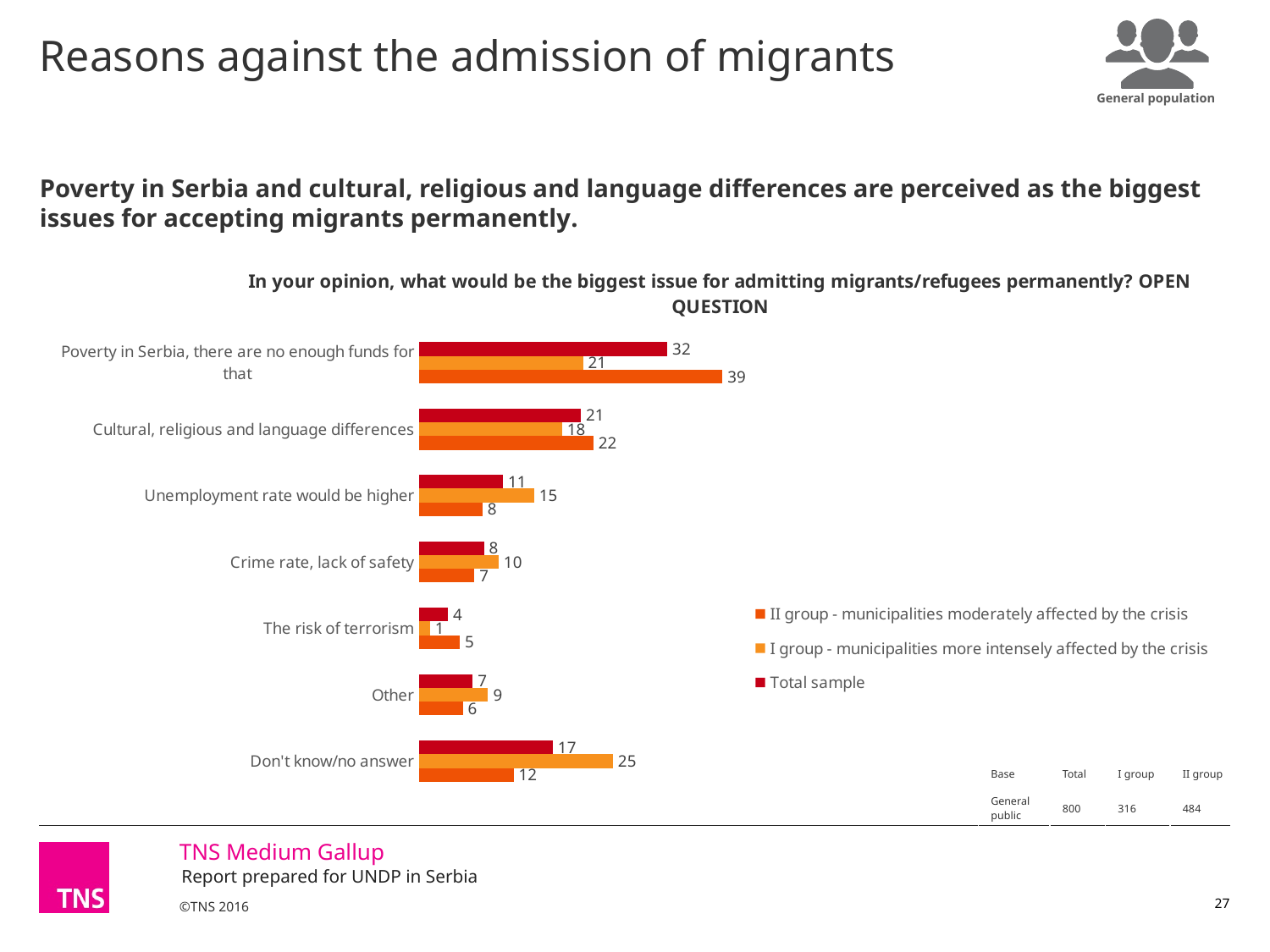
What is the value for the II group (municipalities moderately affected by the crisis) for "Poverty in Serbia, there are no enough funds for that"? 39 Which category has the highest Total sample value? Poverty in Serbia, there are no enough funds for that What is the difference between the II group and I group values for "Poverty in Serbia, there are no enough funds for that"? 18 Which category has the lowest value for the I group? The risk of terrorism What is the Total sample value for "Unemployment rate would be higher"? 11 What is the difference between the I group and II group values for "Don't know/no answer"? 13 What kind of chart is shown on the slide? Bar chart How many series does the legend list? 3 What is the Total sample value for "Poverty in Serbia, there are no enough funds for that"? 32 For "Cultural, religious and language differences", which is larger: the Total sample value or the I group value? Total sample How many categories (reasons) are shown on the chart? 7 What is the value for the I group (municipalities more intensely affected by the crisis) for "Don't know/no answer"? 25